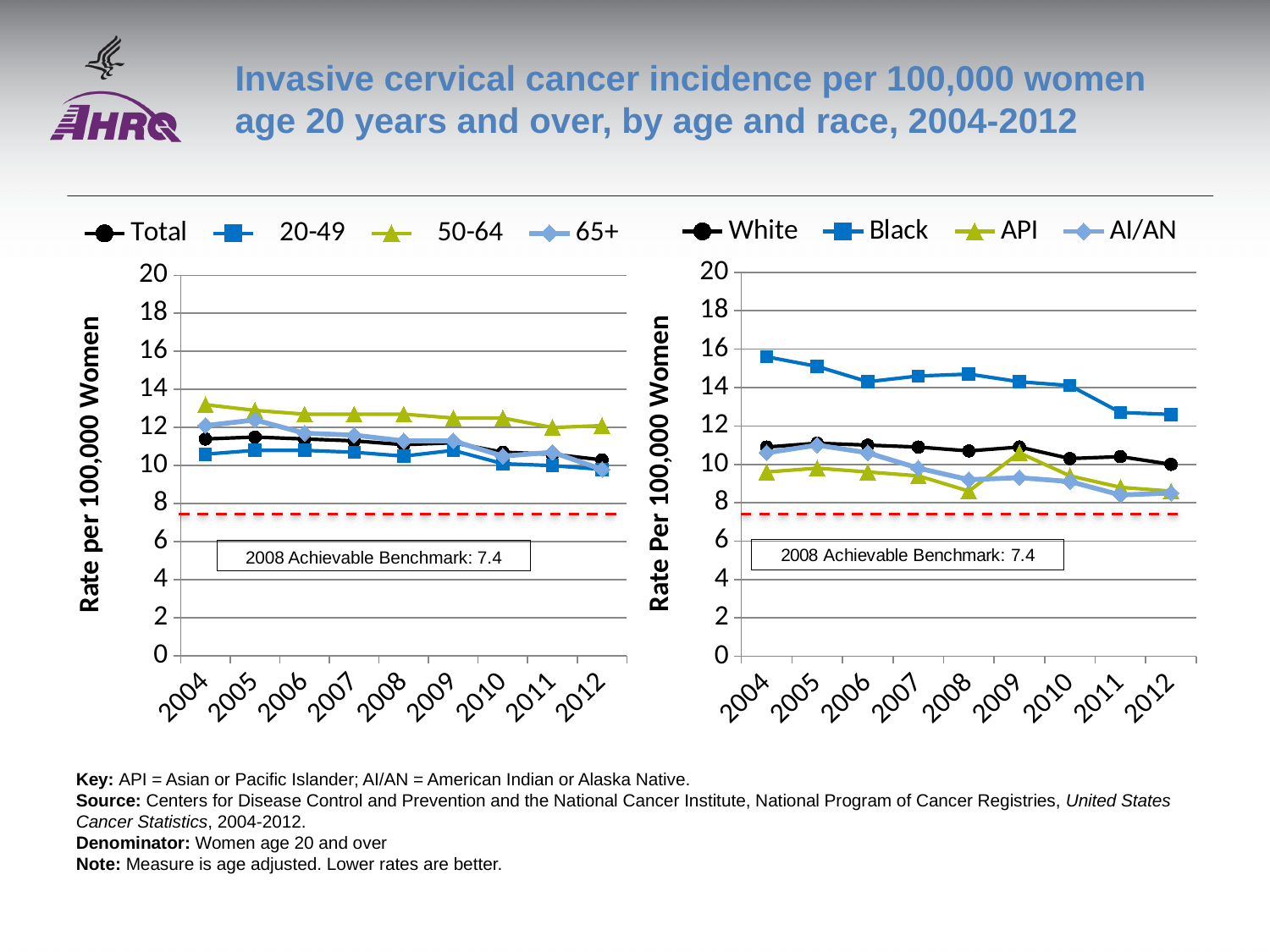
How many years are shown on the x axis of the left chart (by age)? 9 In the right chart (by race), which group has the lowest rate in 2004? API In the left chart (by age), which age group has the highest rate in 2004? 50-64 In the right chart (by race), does the rate for Black rise or fall from 2004 to 2012? Fall What kind of chart is the left chart (by age)? Line chart In the left chart (by age), which age group has the lowest rate in 2004? 20-49 How many series does the legend of the right chart (by race) list? 4 What is the 2008 Achievable Benchmark shown on the charts? 7.4 In the right chart (by race), is the value for Black in 2004 greater or less than 14? greater In the right chart (by race), which group has the highest rate in 2004? Black In the left chart (by age), is the value for 20-49 in 2004 greater or less than 12? less In the left chart (by age), is the value for 50-64 in 2004 greater or less than 12? greater